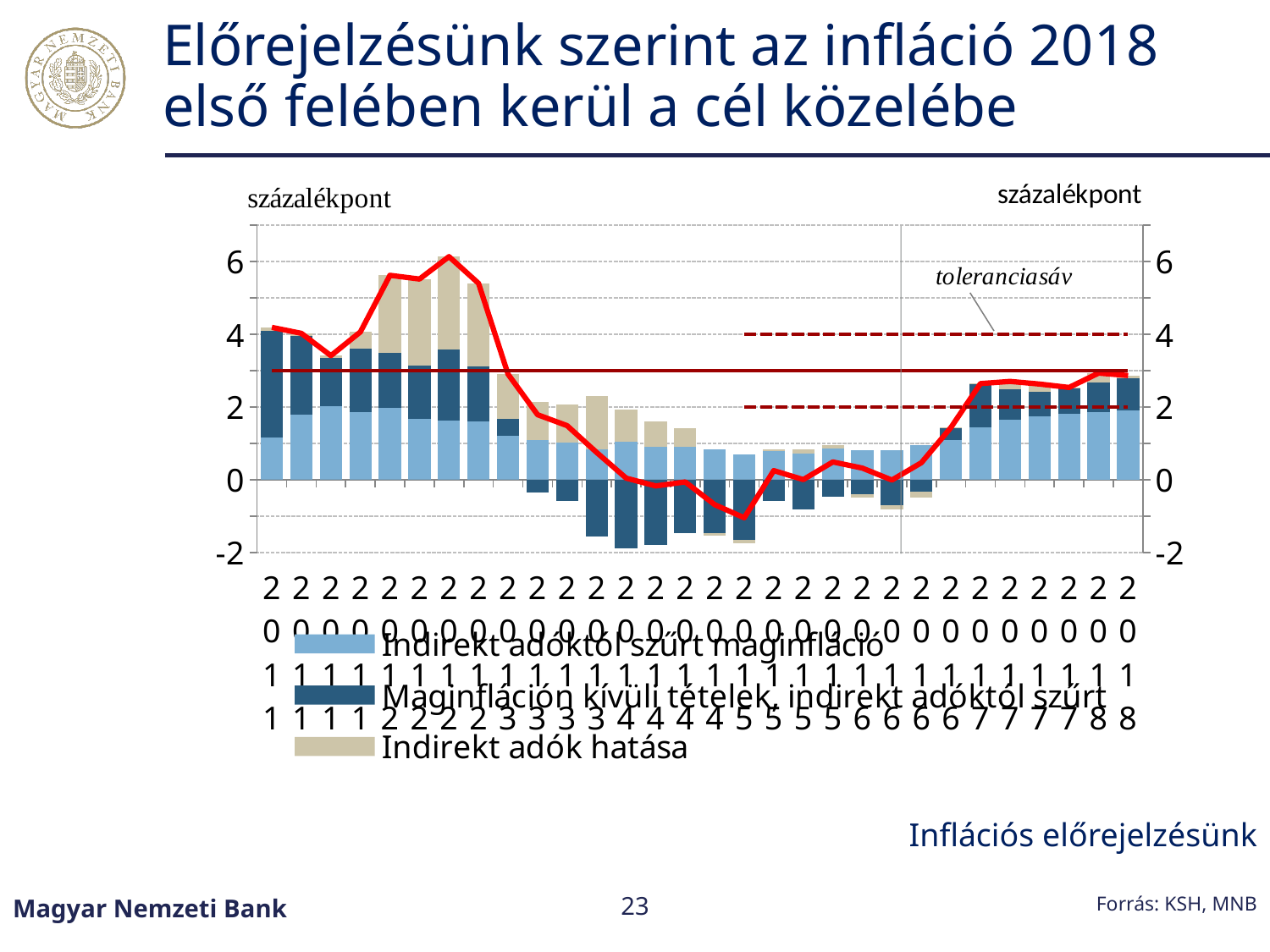
What kind of chart is shown on the slide? bar chart (stacked) with a line Does the red line rise or fall between its 2012 peak and its 2015 low point? fall Is the value of the red line at its peak in 2012 greater or less than 4? greater What is the highest value shown on the vertical axis? 6 How many series does the legend list? 3 Is the value of the red line at its lowest point in 2015 greater or less than 0? less What is the lowest value shown on the vertical axis? -2 Is the value of the red line at the end of 2013 (2013 Q4) greater or less than 2? less Does the red line rise or fall between the start of 2015 and the start of 2017? rise What unit label is shown above the vertical axes? százalékpont